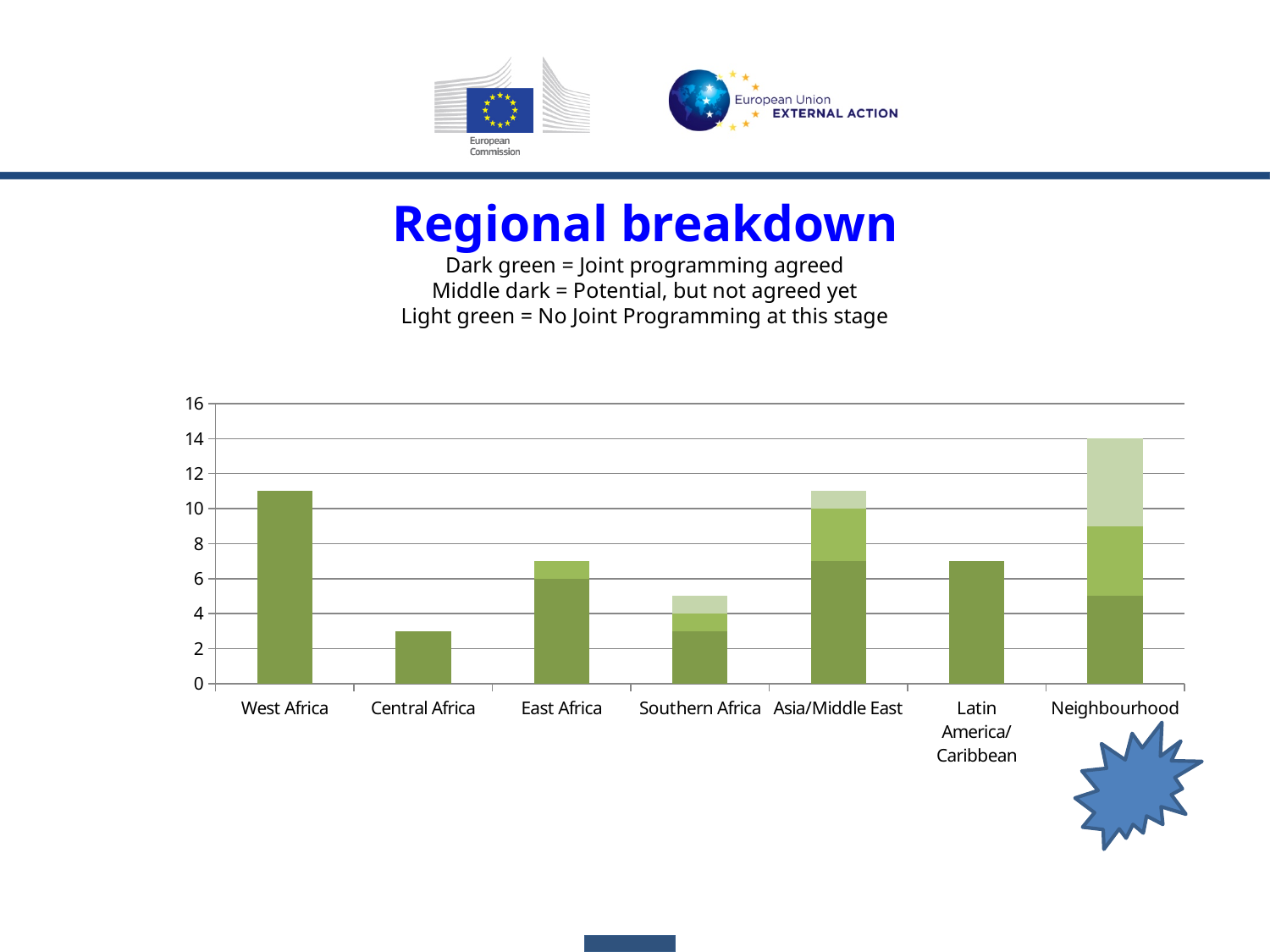
Is the total value for Asia/Middle East greater or less than 10? greater Is the value for Latin America/Caribbean greater or less than 6? greater What type of chart is shown on the slide? Stacked bar chart Is the value for West Africa greater or less than 10? greater What is the total height of the Neighbourhood bar? 14 According to the slide, what does the dark green colour in the chart represent? Joint programming agreed How many regions are shown on the x axis of the chart? 7 Which bar is taller, Southern Africa or Central Africa? Southern Africa Which region has the shortest bar in the chart? Central Africa Which region has the tallest bar in the chart? Neighbourhood What is the title of the chart on the slide? Regional breakdown